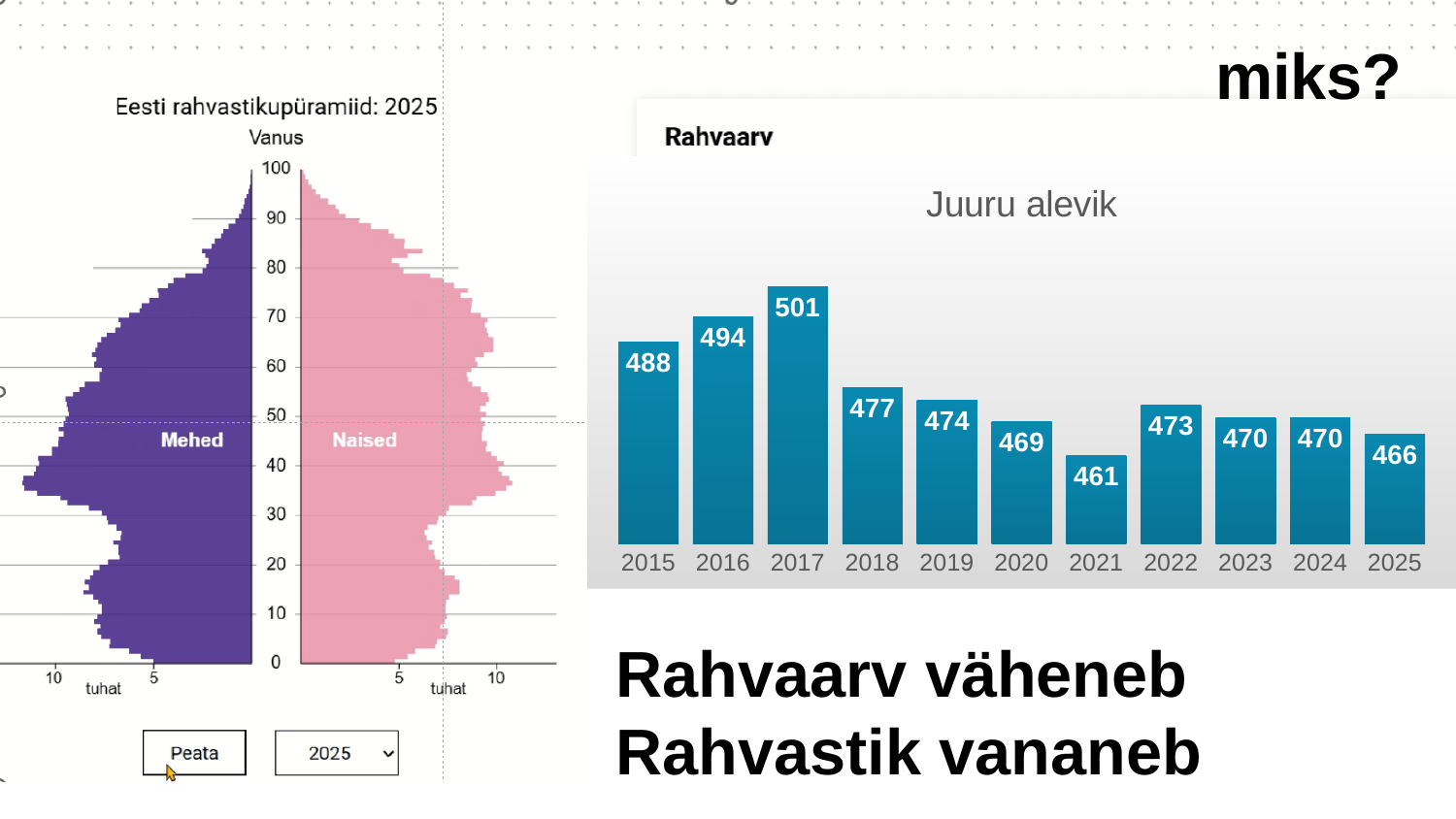
How many years are shown in the Juuru alevik chart? 11 In the Juuru alevik chart, what is the value for 2025? 466 In the Juuru alevik chart, which year has the highest value? 2017 What are the two group labels shown on the population pyramid on the left of the slide? Mehed and Naised In the Juuru alevik chart, which is larger, the value for 2018 or the value for 2022? 2018 In the Juuru alevik chart, what is the difference between the values for 2017 and 2025? 35 In the Juuru alevik chart, what is the difference between the values for 2015 and 2016? 6 What kind of chart is the Juuru alevik chart? bar chart In the Juuru alevik chart, what is the value for 2017? 501 In the Juuru alevik chart, do the values generally rise or fall from 2017 to 2021? fall In the Juuru alevik chart, which year has the lowest value? 2021 In the Juuru alevik chart, what is the value for 2021? 461